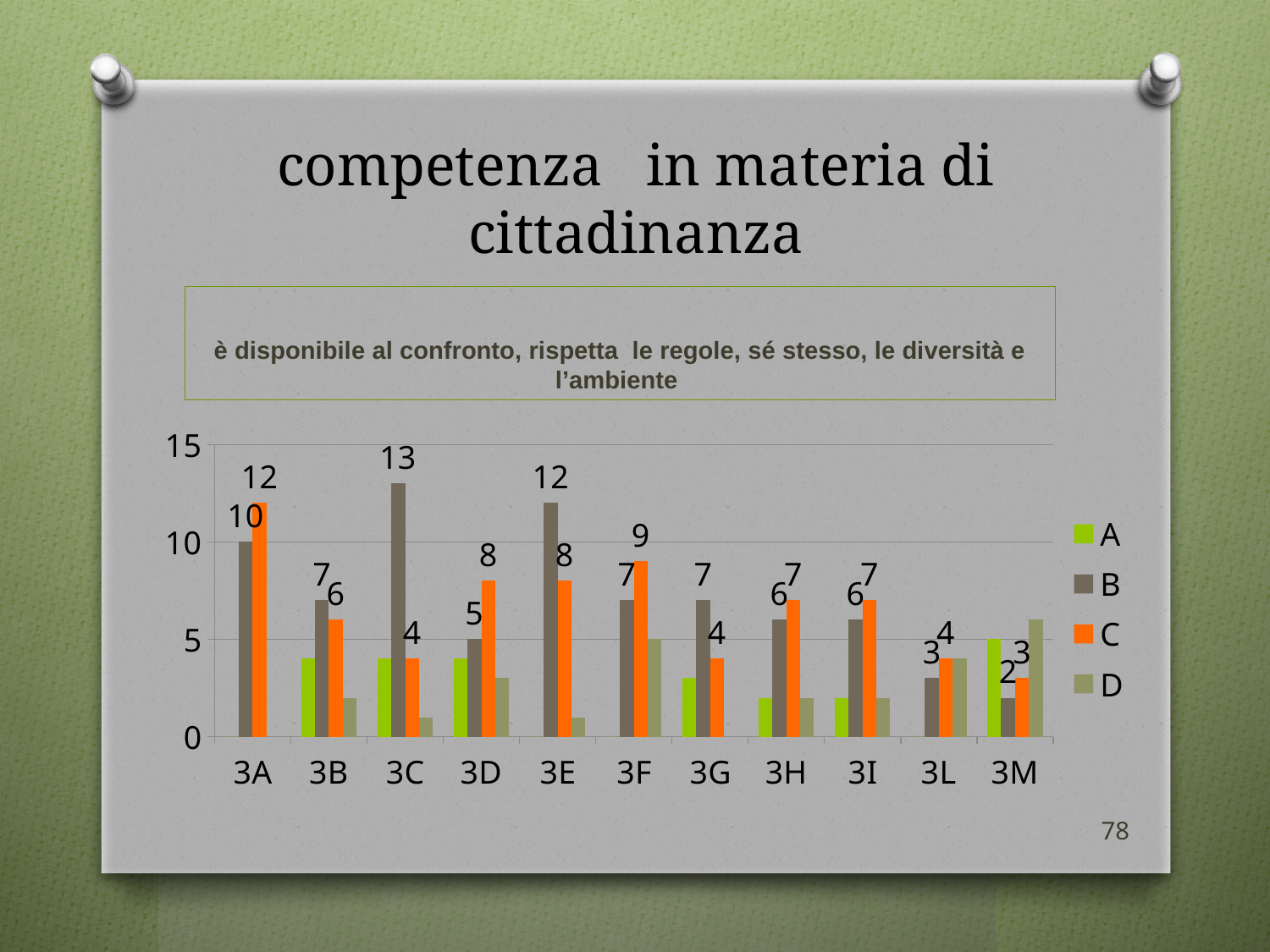
How many classes are shown along the x axis? 11 What is the value of series C for class 3D? 8 For class 3F, which is larger: series B or series C? C How many series does the legend list? 4 What is the difference between series C and series B for class 3A? 2 Which class has the lowest value for series B? 3M Which class has the highest value for series B? 3C Which class has the highest value for series C? 3A Is the value of series A for class 3B greater or less than 5? less What is the value of series B for class 3C? 13 What kind of chart is shown on the slide? bar chart What is the value of series C for class 3A? 12